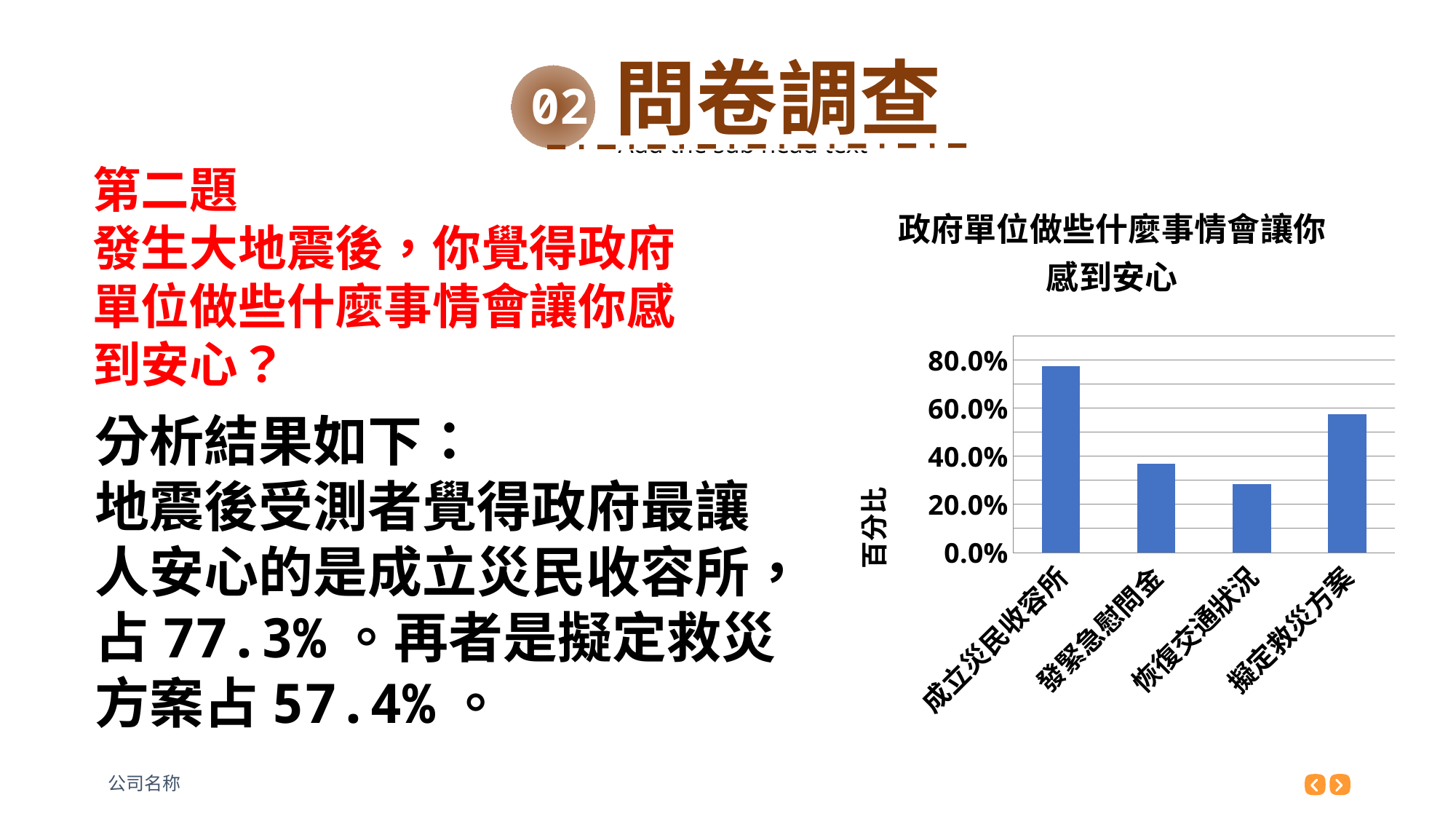
What kind of chart is shown on the slide? bar chart Is the value for 擬定救災方案 greater or less than 60.0%? less Is the value for 恢復交通狀況 greater or less than 20.0%? greater Which category has the lowest value in the chart? 恢復交通狀況 Which category has the highest value in the chart? 成立災民收容所 Is the value for 發緊急慰問金 greater or less than 40.0%? less What is the value for 擬定救災方案? 57.4% What is the label on the vertical axis of the chart? 百分比 What is the difference between the values for 成立災民收容所 and 擬定救災方案? 19.9% What is the value for 成立災民收容所? 77.3% Which is larger, the value for 發緊急慰問金 or the value for 恢復交通狀況? 發緊急慰問金 How many categories are plotted in the chart? 4